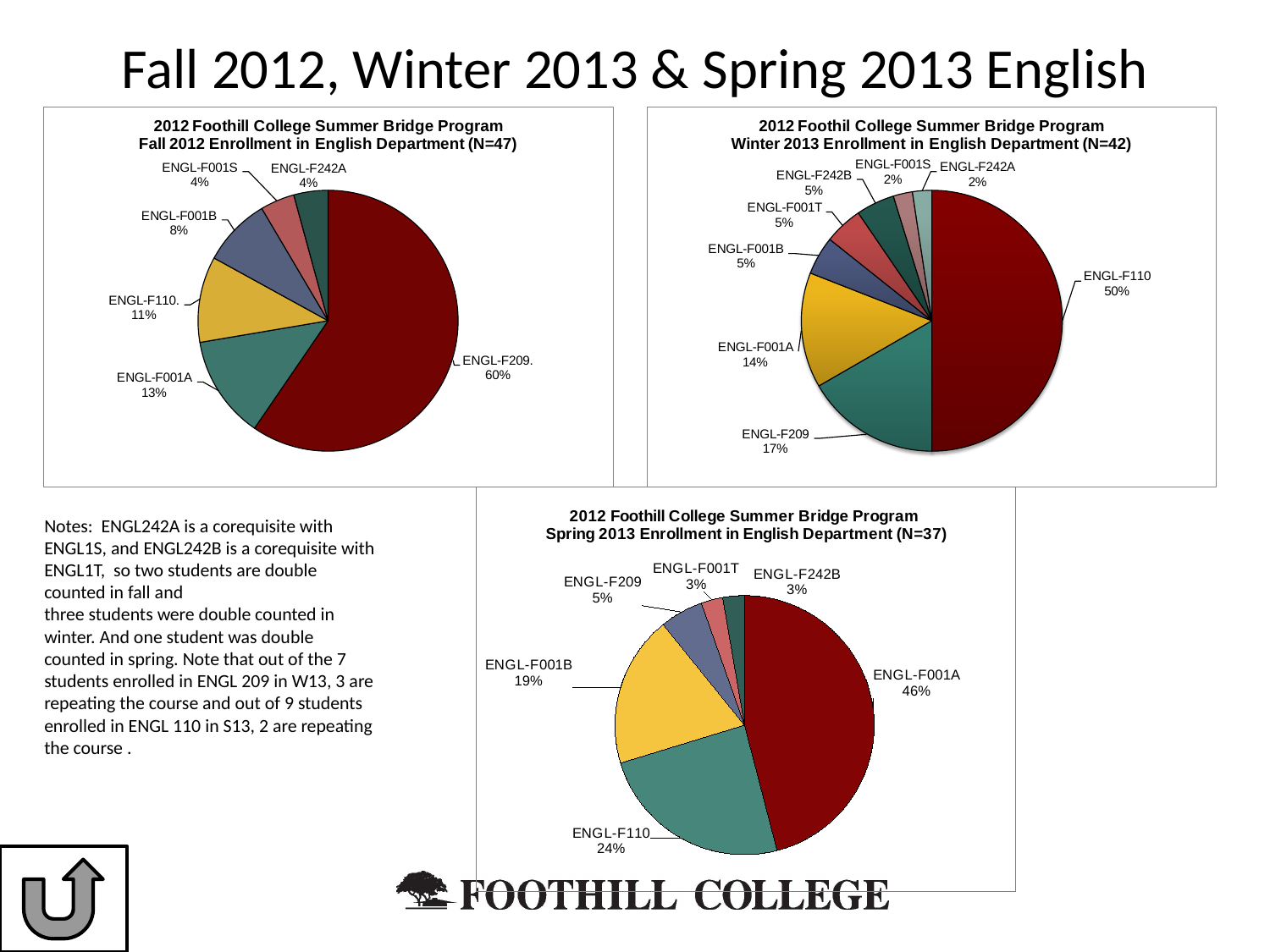
In the Spring 2013 Enrollment in English Department pie chart, what share does ENGL-F110 have? 24% How many slices does the Fall 2012 Enrollment in English Department pie chart have? 6 In the Fall 2012 Enrollment in English Department pie chart, which course has the largest share? ENGL-F209 In the Winter 2013 Enrollment in English Department pie chart, which is larger, ENGL-F209 or ENGL-F001A? ENGL-F209 In the Fall 2012 Enrollment in English Department pie chart, what share does ENGL-F209 have? 60% In the Winter 2013 Enrollment in English Department pie chart, what share does ENGL-F110 have? 50% How many slices does the Winter 2013 Enrollment in English Department pie chart have? 8 In the Spring 2013 Enrollment in English Department pie chart, what is the difference in percentage points between ENGL-F001A and ENGL-F001B? 27 In the Spring 2013 Enrollment in English Department pie chart, which course has the largest share? ENGL-F001A What type of chart is used for the Spring 2013 Enrollment in English Department? Pie chart In the Fall 2012 Enrollment in English Department pie chart, what is the difference in percentage points between ENGL-F001A and ENGL-F110? 2